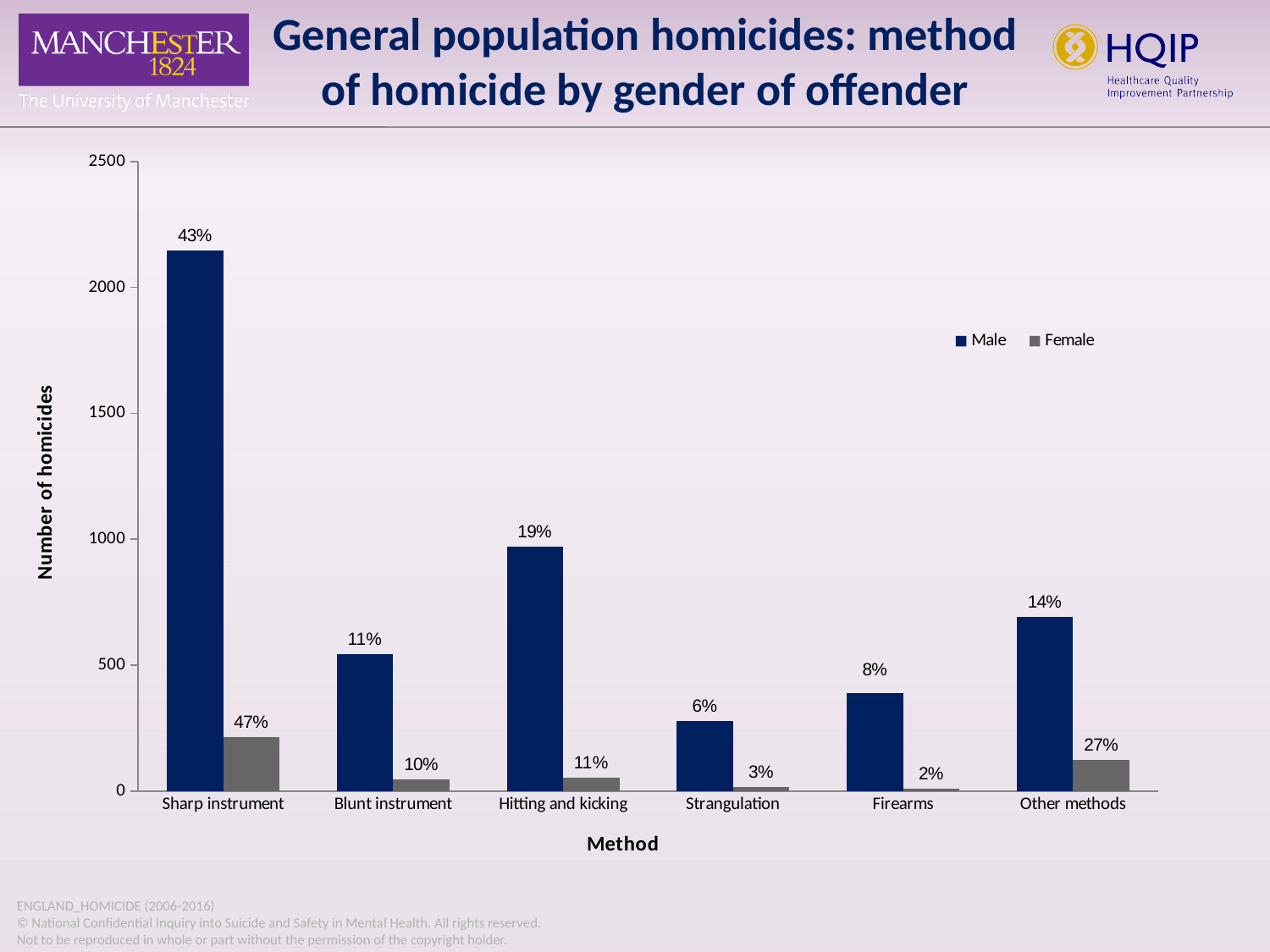
Which is larger, the Male bar for Firearms or the Male bar for Blunt instrument? Blunt instrument What percentage label is shown on the Female bar for Other methods? 27% What type of chart is shown on the slide? Bar chart Which method has the tallest Female bar? Sharp instrument Which method has the shortest Male bar? Strangulation What percentage label is shown on the Male bar for Sharp instrument? 43% How many methods are shown on the x axis? 6 Is the number of homicides for Male Sharp instrument greater or less than 2000? greater Which method has the tallest Male bar? Sharp instrument How many series does the legend list? 2 What percentage label is shown on the Female bar for Firearms? 2%